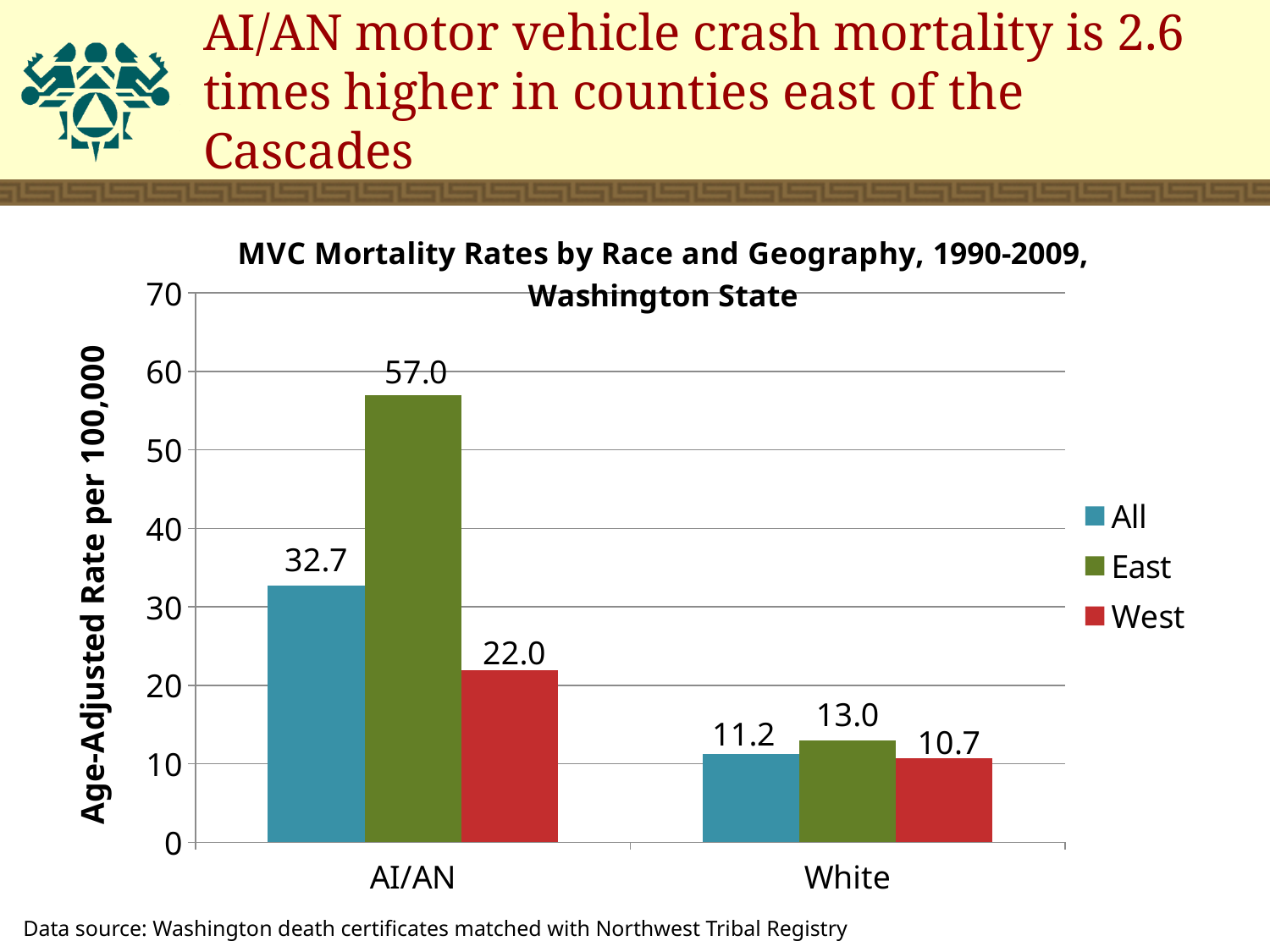
What is the West value for White? 10.7 What is the difference between the East and West values for AI/AN? 35.0 How many categories are shown on the x axis? 2 What kind of chart is shown? Bar chart What is the All value for AI/AN? 32.7 Which series has the lowest value for White? West Which is larger, the All value for AI/AN or the All value for White? AI/AN What is the East value for AI/AN? 57.0 What is the difference between the East values for AI/AN and White? 44.0 How many series does the legend list? 3 Which series has the highest value for AI/AN? East What is the y-axis label of the chart? Age-Adjusted Rate per 100,000